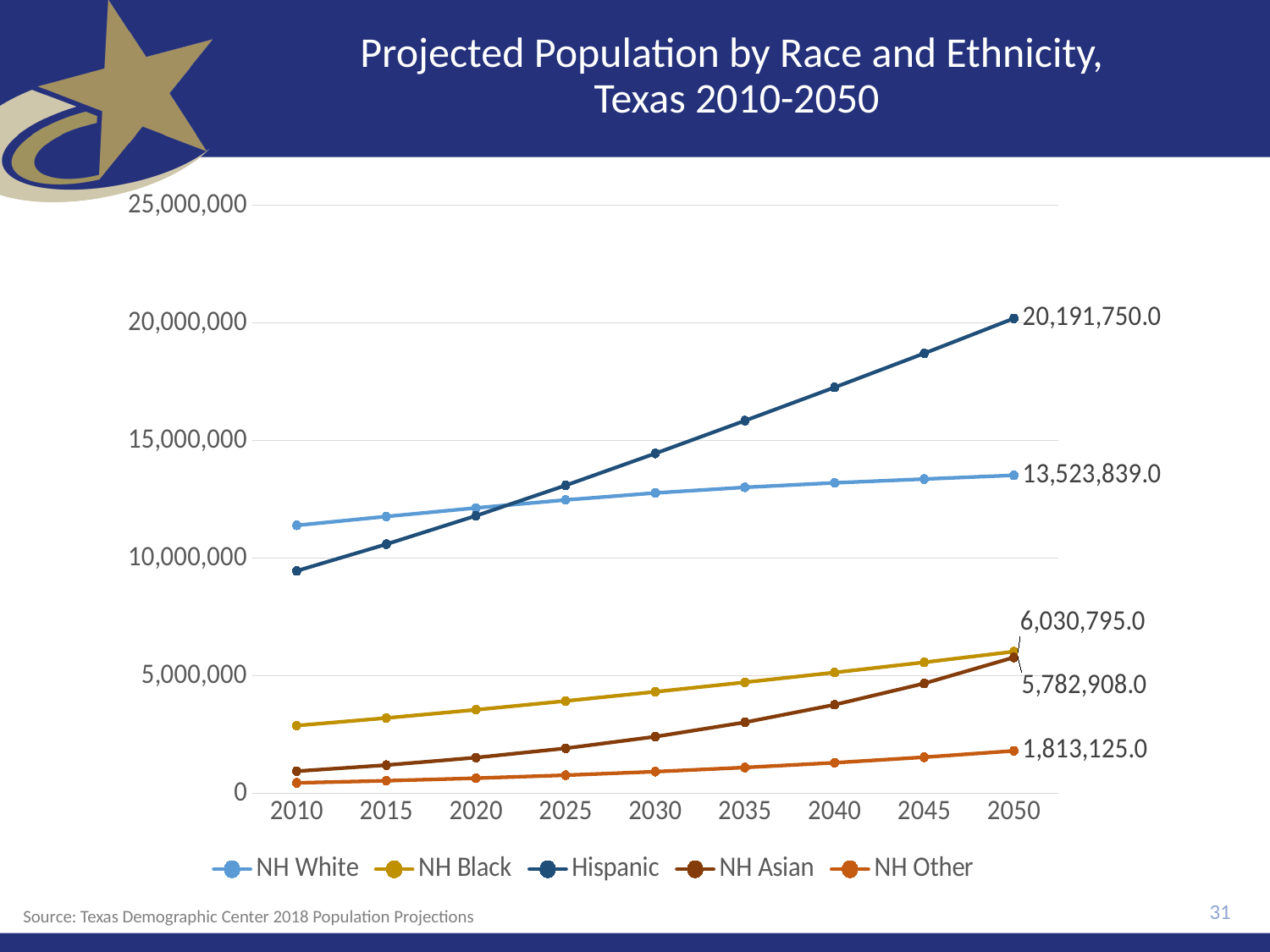
What is the projected NH Other population in Texas in 2050? 1,813,125.0 Which group has the lowest projected population in 2050? NH Other What is the difference between the projected Hispanic and NH White populations in 2050? 6,667,911.0 Is the Hispanic population in 2010 greater or less than 10,000,000? less What is the projected NH White population in Texas in 2050? 13,523,839.0 What is the projected NH Asian population in Texas in 2050? 5,782,908.0 How many series does the legend list? 5 Does the Hispanic population rise or fall from 2010 to 2050? rise What kind of chart is shown on the slide? line chart What is the projected Hispanic population in Texas in 2050? 20,191,750.0 Which group has the highest projected population in 2050? Hispanic What is the projected NH Black population in Texas in 2050? 6,030,795.0